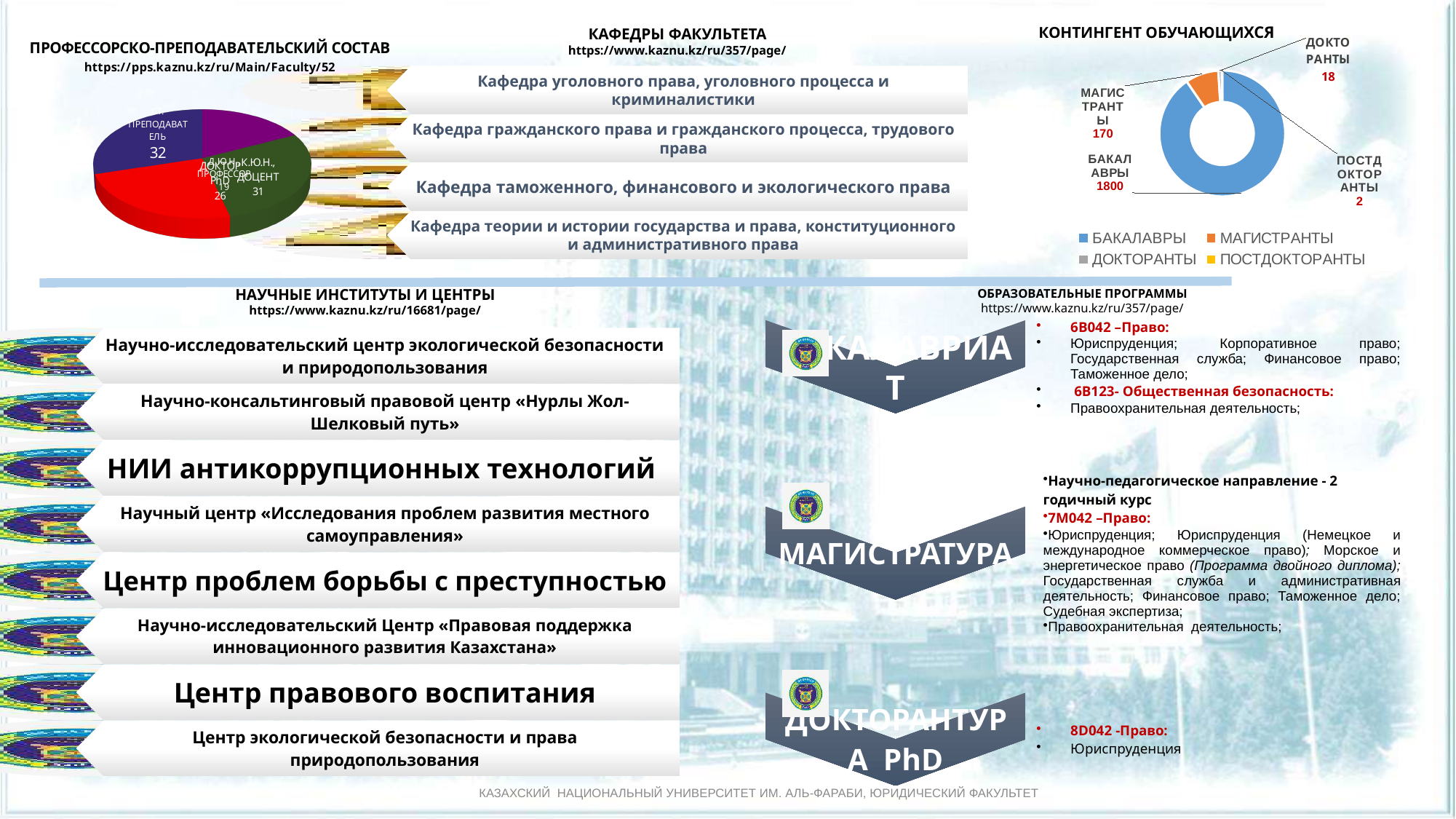
In the 'КОНТИНГЕНТ ОБУЧАЮЩИХСЯ' chart, what is the value for ПОСТДОКТОРАНТЫ? 2 How many categories does the legend of the 'КОНТИНГЕНТ ОБУЧАЮЩИХСЯ' chart list? 4 What kind of chart is the 'КОНТИНГЕНТ ОБУЧАЮЩИХСЯ' chart? Donut (pie) chart What kind of chart is the 'ПРОФЕССОРСКО-ПРЕПОДАВАТЕЛЬСКИЙ СОСТАВ' chart? Pie chart In the 'КОНТИНГЕНТ ОБУЧАЮЩИХСЯ' chart, which category has the smallest value? ПОСТДОКТОРАНТЫ In the 'КОНТИНГЕНТ ОБУЧАЮЩИХСЯ' chart, what is the value for ДОКТОРАНТЫ? 18 In the 'ПРОФЕССОРСКО-ПРЕПОДАВАТЕЛЬСКИЙ СОСТАВ' chart, what is the value for ПРЕПОДАВАТЕЛЬ? 32 In the 'КОНТИНГЕНТ ОБУЧАЮЩИХСЯ' chart, what is the value for БАКАЛАВРЫ? 1800 In the 'ПРОФЕССОРСКО-ПРЕПОДАВАТЕЛЬСКИЙ СОСТАВ' chart, what is the value for К.Ю.Н., ДОЦЕНТ? 31 In the 'КОНТИНГЕНТ ОБУЧАЮЩИХСЯ' chart, which category has the largest value? БАКАЛАВРЫ In the 'КОНТИНГЕНТ ОБУЧАЮЩИХСЯ' chart, what is the value for МАГИСТРАНТЫ? 170 In the 'КОНТИНГЕНТ ОБУЧАЮЩИХСЯ' chart, what is the difference between БАКАЛАВРЫ and МАГИСТРАНТЫ? 1630